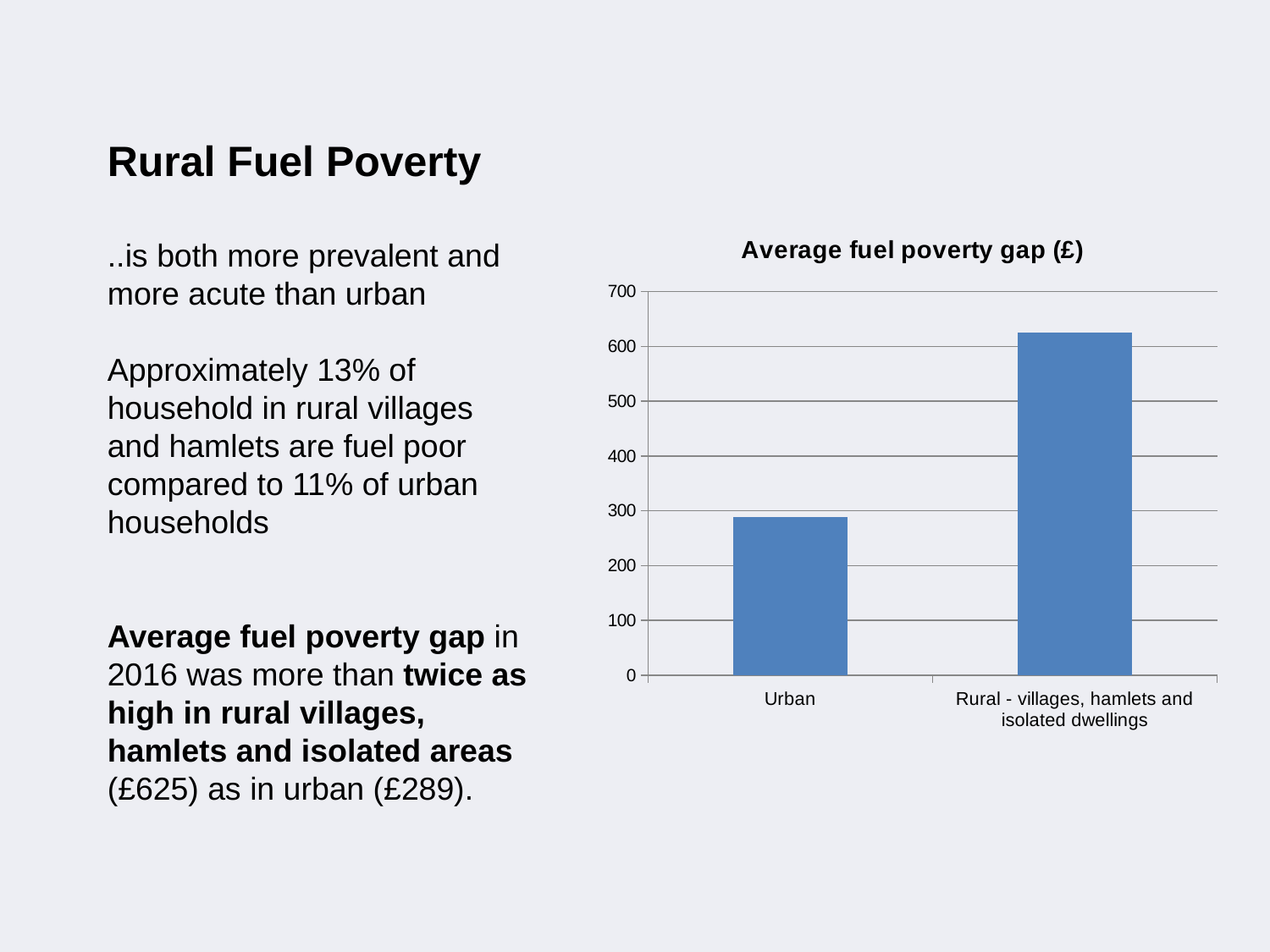
Is the value for Rural - villages, hamlets and isolated dwellings greater or less than 600? greater According to the slide, what is the average fuel poverty gap for Urban households? £289 What kind of chart is shown on the slide? bar chart Which category has the lowest average fuel poverty gap? Urban How many categories are shown on the chart? 2 Which category has the highest average fuel poverty gap? Rural - villages, hamlets and isolated dwellings According to the slide, what is the average fuel poverty gap for rural villages, hamlets and isolated areas? £625 What is the highest value shown on the vertical axis of the chart? 700 What is the title of the chart? Average fuel poverty gap (£) Is the value for Urban greater or less than 200? greater Is the value for Urban greater or less than 300? less Which is larger, the average fuel poverty gap for Urban or for Rural - villages, hamlets and isolated dwellings? Rural - villages, hamlets and isolated dwellings